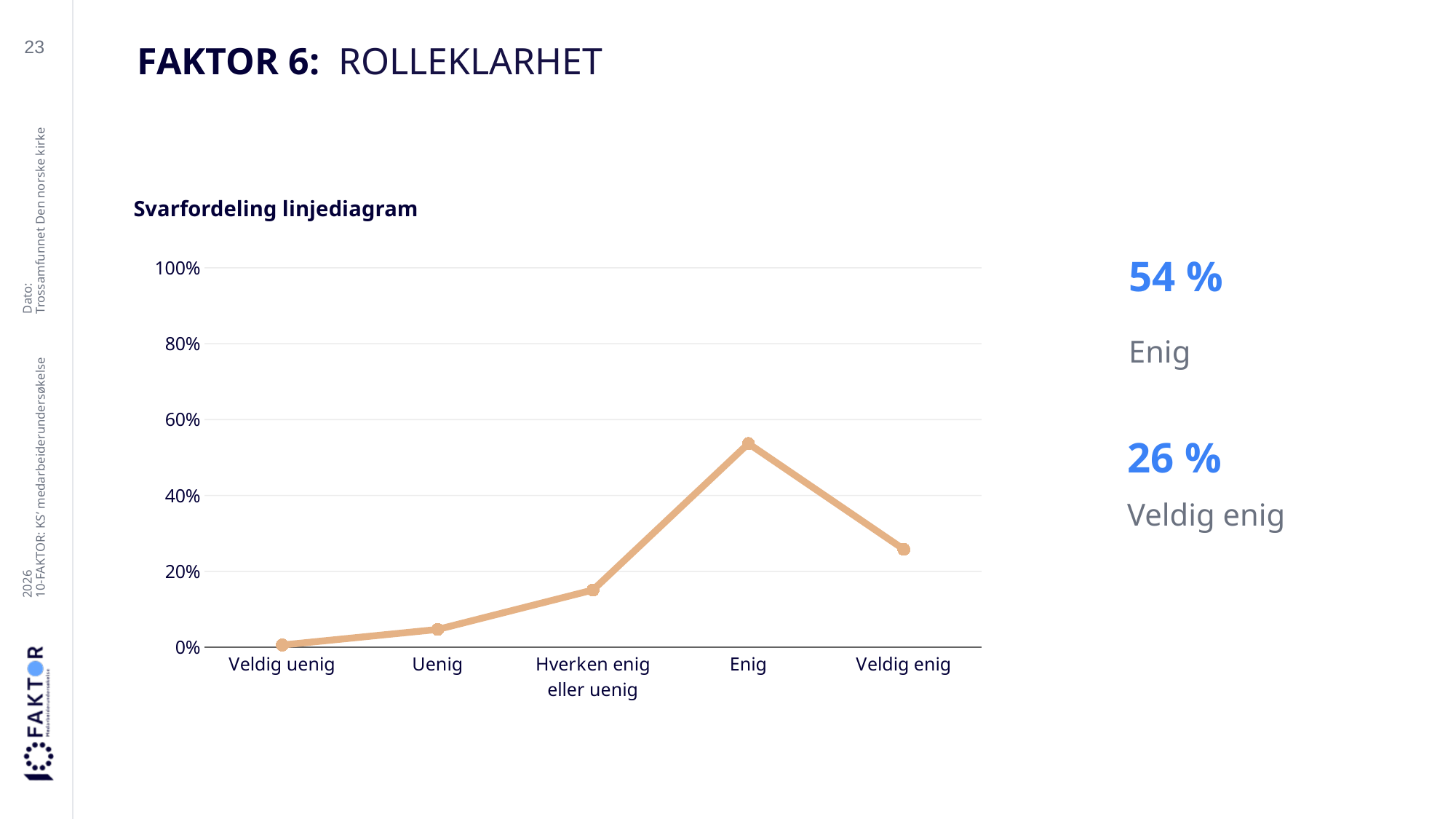
Which is larger, the value for Enig or the value for Veldig enig? Enig What is the title of the chart? Svarfordeling linjediagram Which category has the highest value? Enig Which category has the lowest value? Veldig uenig What is the value for Veldig enig? 26 % Does the line rise or fall from Veldig uenig to Enig? rise Is the value for Uenig greater or less than 20%? less What kind of chart is shown on the slide? line chart What is the value for Enig? 54 % What is the difference between the values for Enig and Veldig enig? 28 % Is the value for Hverken enig eller uenig greater or less than 20%? less How many categories are plotted along the x axis? 5